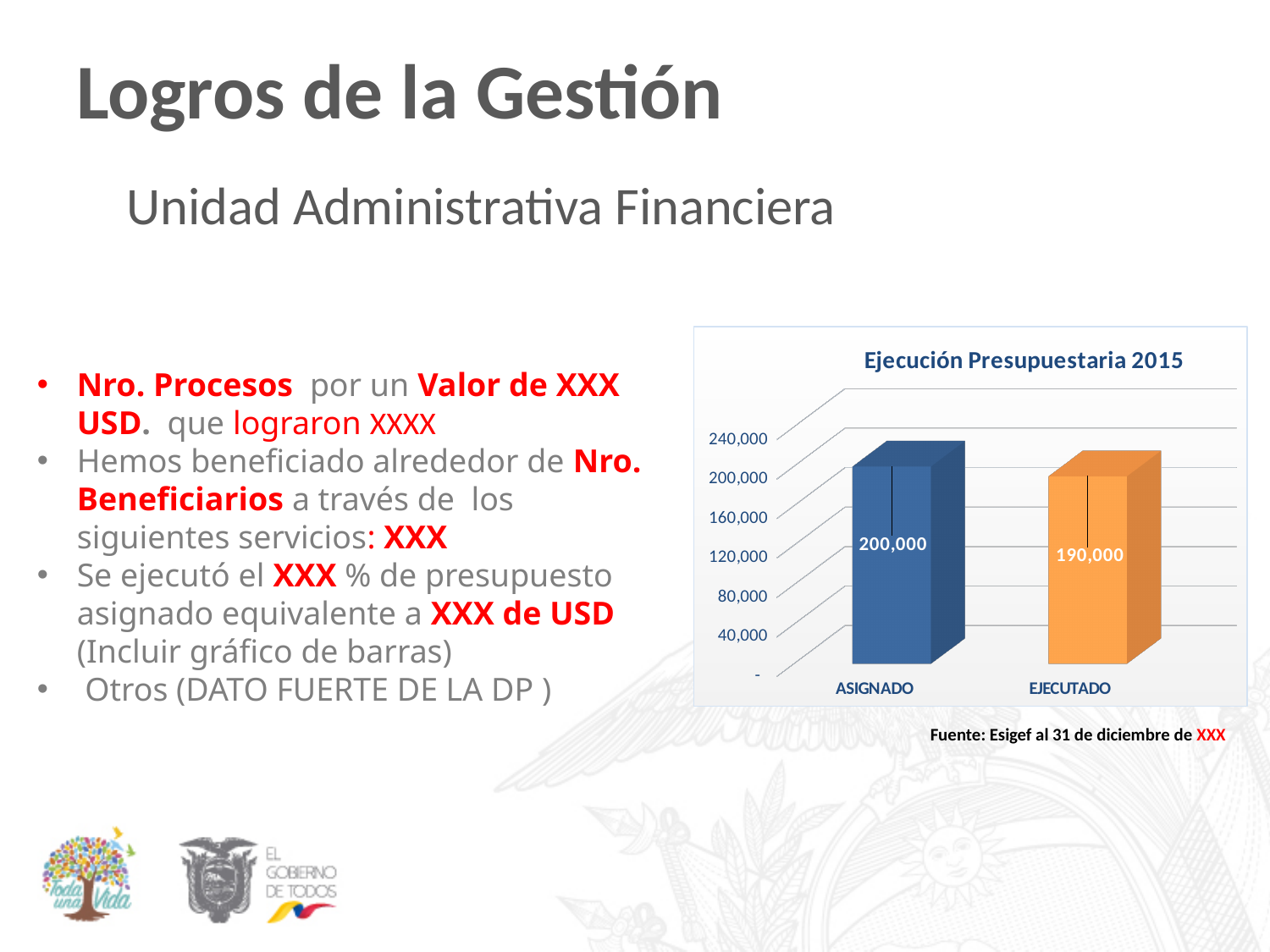
What colour is the bar for EJECUTADO? orange Which is larger, the value for ASIGNADO or the value for EJECUTADO? ASIGNADO Which category has the lowest value in the chart? EJECUTADO Do the values rise or fall from ASIGNADO to EJECUTADO? fall What is the difference between the ASIGNADO and EJECUTADO values? 10,000 What kind of chart is shown on the slide? bar chart Is the value for EJECUTADO greater or less than 160,000? greater What is the value for EJECUTADO in the chart? 190,000 How many categories are shown in the chart? 2 Which category has the highest value in the chart? ASIGNADO What is the title of the chart? Ejecución Presupuestaria 2015 What is the value for ASIGNADO in the chart? 200,000